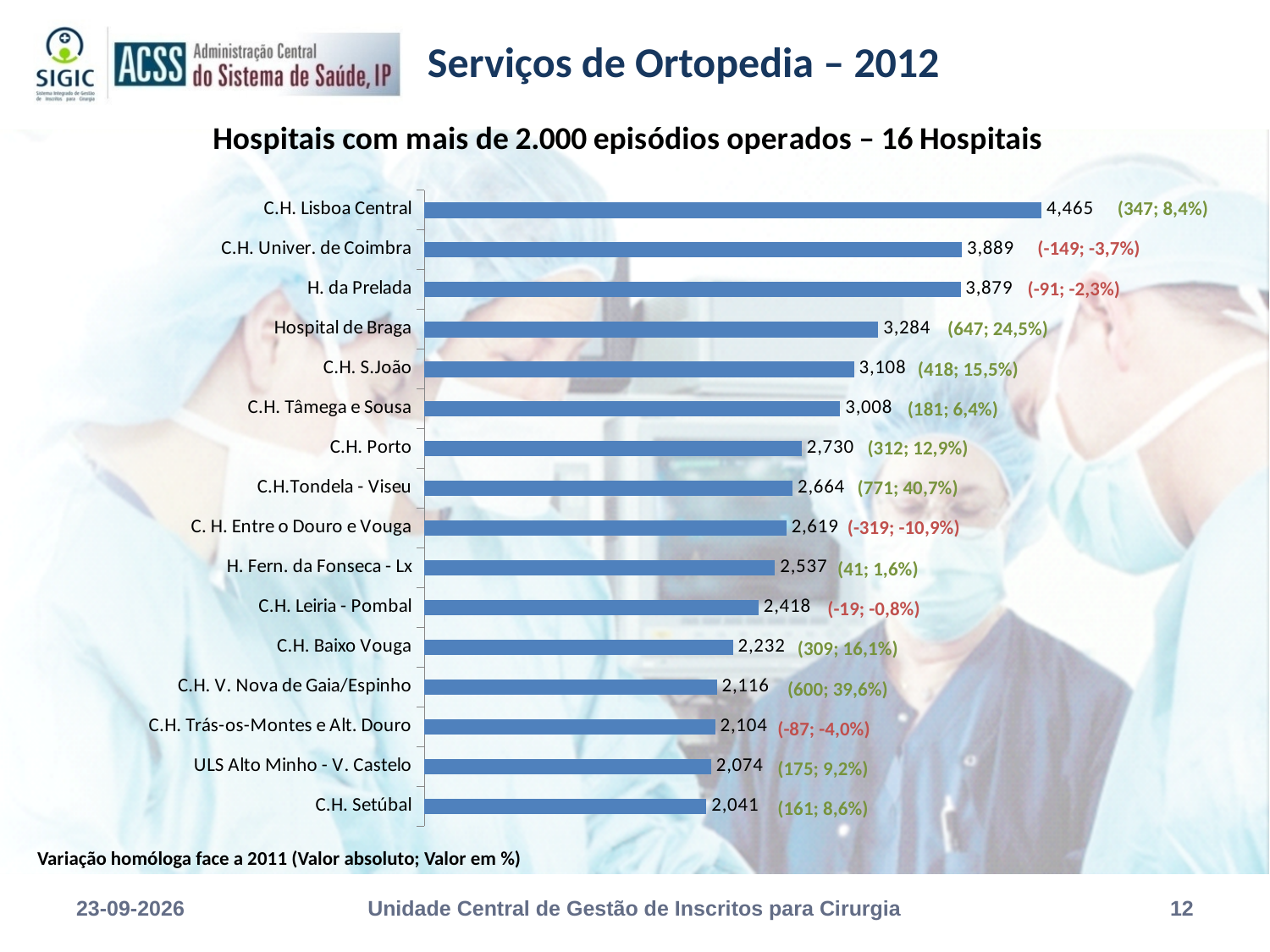
What is the difference between the values for C.H. Univer. de Coimbra and H. da Prelada? 10 Which is larger, the value for C.H. Porto or the value for C.H. Baixo Vouga? C.H. Porto What is the difference between the values for C.H. Lisboa Central and C.H. Setúbal? 2,424 How many hospitals are shown in the chart? 16 What kind of chart is shown on the slide? Bar chart What is the value for Hospital de Braga? 3,284 Which hospital has the highest value? C.H. Lisboa Central Which hospital has the lowest value? C.H. Setúbal What is the percentage variation shown next to C.H.Tondela - Viseu? 40,7% What is the title of the chart? Hospitais com mais de 2.000 episódios operados – 16 Hospitais What is the value for C.H. Setúbal? 2,041 What is the value for C.H. Lisboa Central? 4,465